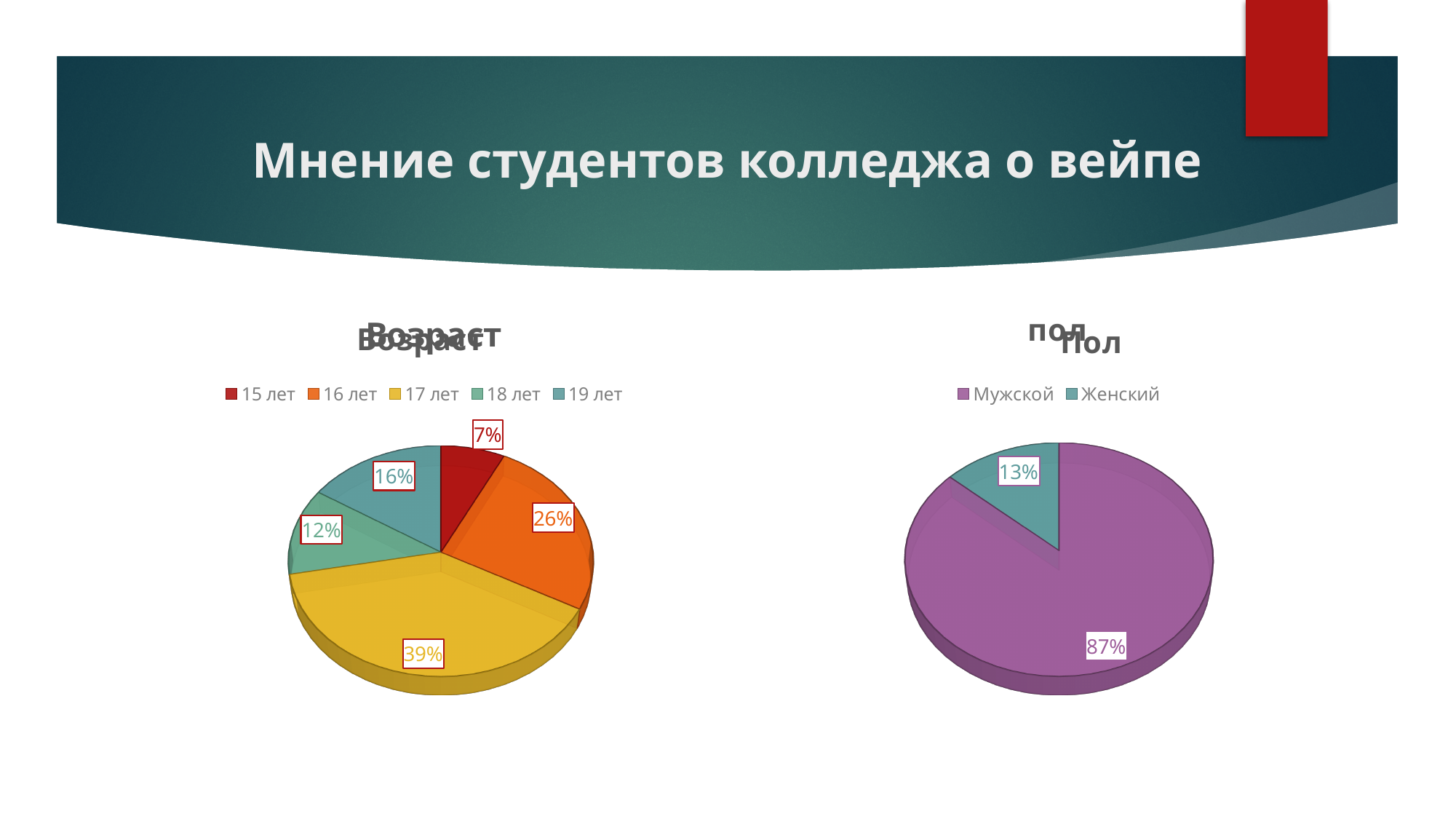
In the 'Пол' pie chart, what is the difference between the shares for Мужской and Женский? 74% In the 'Возраст' pie chart, what share is shown for 19 лет? 16% In the 'Возраст' pie chart, which age group has the largest share? 17 лет In the 'Пол' pie chart, what share is shown for Женский? 13% In the 'Возраст' pie chart, what share is shown for 17 лет? 39% In the 'Возраст' pie chart, which age group has the smallest share? 15 лет In the 'Пол' pie chart, what share is shown for Мужской? 87% What kind of chart is the chart on the right of the slide? Pie chart How many categories does the legend of the 'Возраст' pie chart list? 5 In the 'Возраст' pie chart, what is the difference between the shares for 16 лет and 18 лет? 14% In the 'Возраст' pie chart, what share is shown for 15 лет? 7%